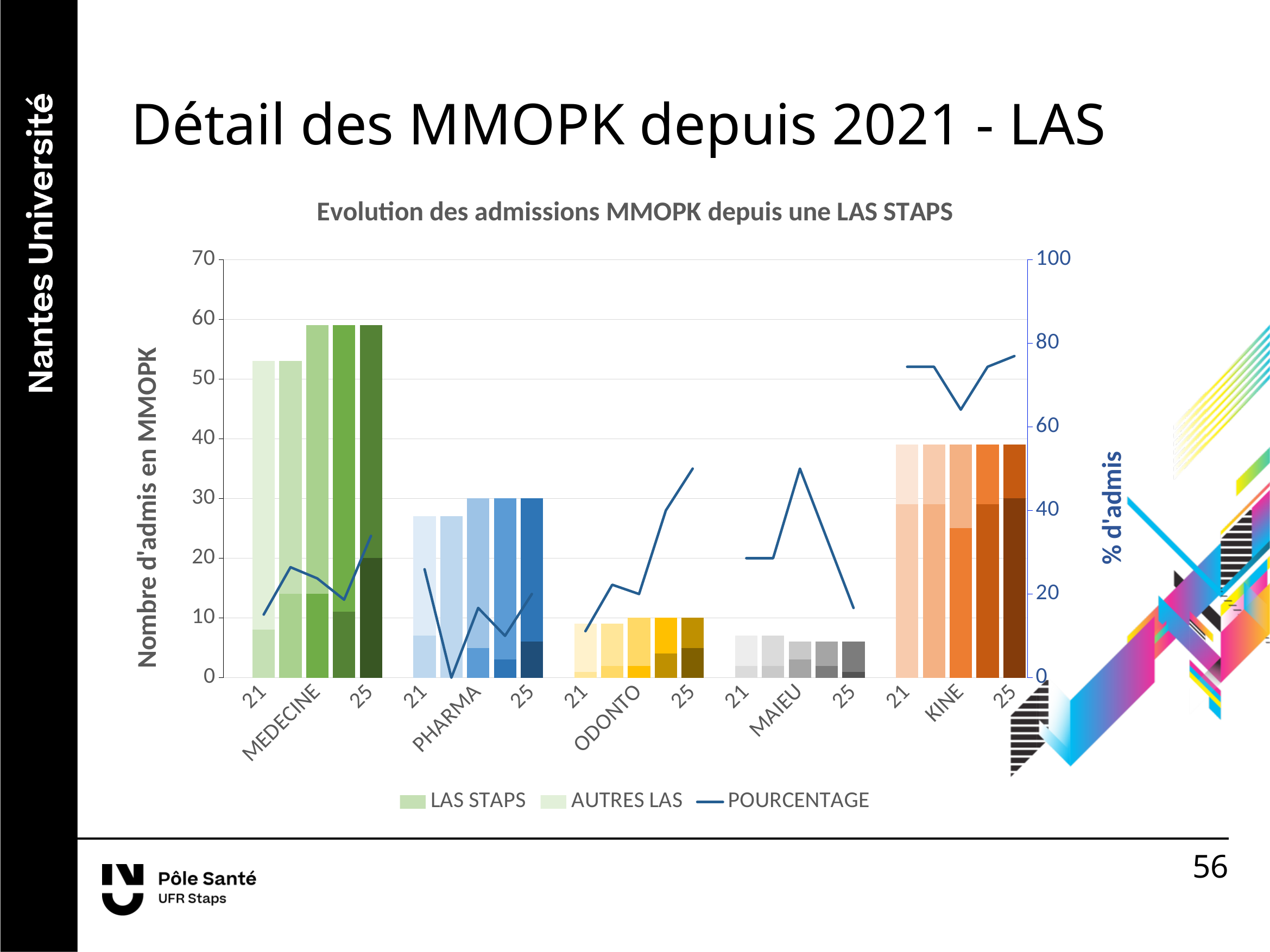
What is the label of the right-hand vertical axis? % d'admis Which discipline has the tallest bars (highest total admissions)? MEDECINE Is the total number of admissions for PHARMA in 21 greater or less than 20? greater How many series does the legend list? 3 What kind of chart is shown on the slide? bar chart with a line Which has the larger total admissions in 25, MEDECINE or KINE? MEDECINE Which discipline has the shortest bars (lowest total admissions)? MAIEU What is the title of the chart? Evolution des admissions MMOPK depuis une LAS STAPS How many disciplines (category groups) are shown along the x axis? 5 Is the total number of admissions for MAIEU in 25 greater or less than 10? less Is the total number of admissions for KINE in 21 greater or less than 30? greater